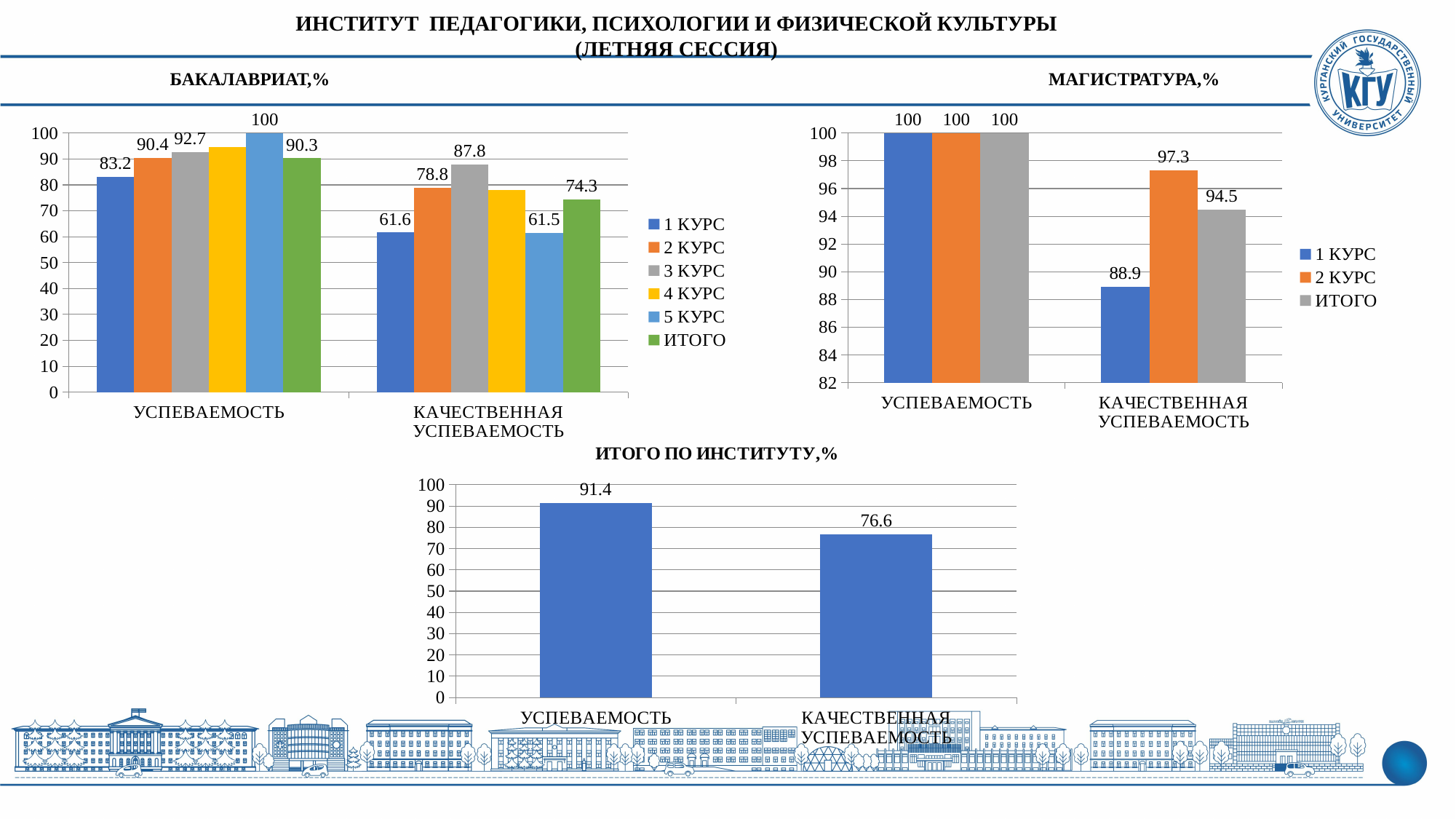
In the БАКАЛАВРИАТ,% chart, what is the value for 1 КУРС in the УСПЕВАЕМОСТЬ category? 83.2 What kind of chart is the ИТОГО ПО ИНСТИТУТУ,% chart? bar chart In the МАГИСТРАТУРА,% chart, what is the value for ИТОГО in the УСПЕВАЕМОСТЬ category? 100 In the МАГИСТРАТУРА,% chart, which series has the lowest value in the КАЧЕСТВЕННАЯ УСПЕВАЕМОСТЬ category? 1 КУРС In the БАКАЛАВРИАТ,% chart, which series has the highest value in the УСПЕВАЕМОСТЬ category? 5 КУРС In the ИТОГО ПО ИНСТИТУТУ,% chart, what is the difference between УСПЕВАЕМОСТЬ and КАЧЕСТВЕННАЯ УСПЕВАЕМОСТЬ? 14.8 In the МАГИСТРАТУРА,% chart, what is the value for 2 КУРС in the КАЧЕСТВЕННАЯ УСПЕВАЕМОСТЬ category? 97.3 In the БАКАЛАВРИАТ,% chart, is the value for 4 КУРС in the КАЧЕСТВЕННАЯ УСПЕВАЕМОСТЬ category greater or less than 70? greater In the БАКАЛАВРИАТ,% chart, how many series does the legend list? 6 In the ИТОГО ПО ИНСТИТУТУ,% chart, what is the value for КАЧЕСТВЕННАЯ УСПЕВАЕМОСТЬ? 76.6 In the БАКАЛАВРИАТ,% chart, what is the difference between the ИТОГО values for УСПЕВАЕМОСТЬ and КАЧЕСТВЕННАЯ УСПЕВАЕМОСТЬ? 16 In the БАКАЛАВРИАТ,% chart, what is the value for 3 КУРС in the КАЧЕСТВЕННАЯ УСПЕВАЕМОСТЬ category? 87.8